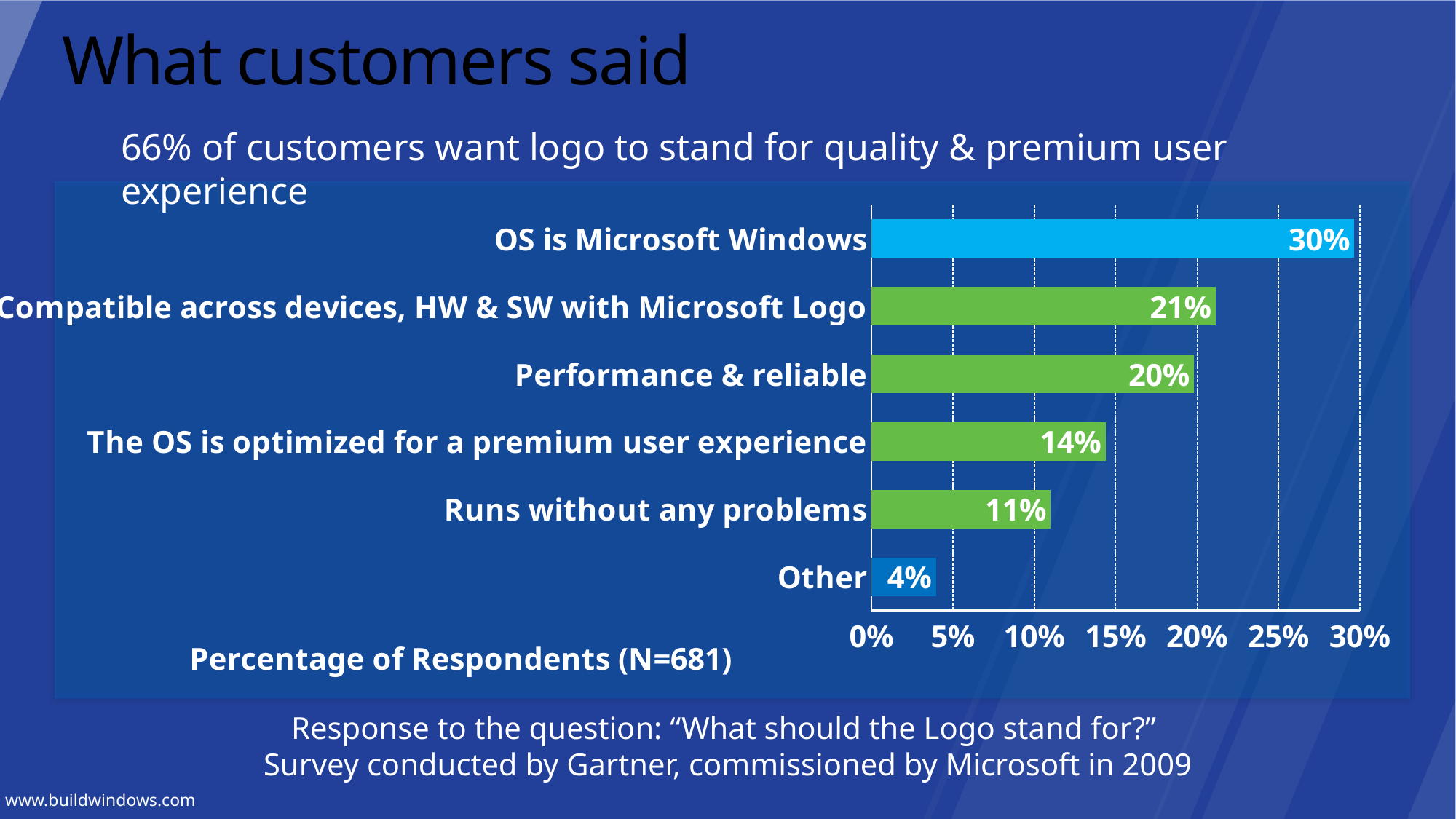
Is the value for "Runs without any problems" greater or less than 15%? less What percentage of respondents said the logo should stand for "OS is Microsoft Windows"? 30% What is the value for "Other"? 4% What is the label of the horizontal axis of the chart? Percentage of Respondents (N=681) Which category has the lowest percentage of respondents? Other What is the difference between the values for "OS is Microsoft Windows" and "The OS is optimized for a premium user experience"? 16% What kind of chart is shown on the slide? bar chart How many categories are shown in the chart? 6 Which is larger: the value for "Compatible across devices, HW & SW with Microsoft Logo" or the value for "Performance & reliable"? Compatible across devices, HW & SW with Microsoft Logo What percentage of respondents chose "Runs without any problems"? 11% What is the value for "Performance & reliable"? 20% Which category has the highest percentage of respondents? OS is Microsoft Windows